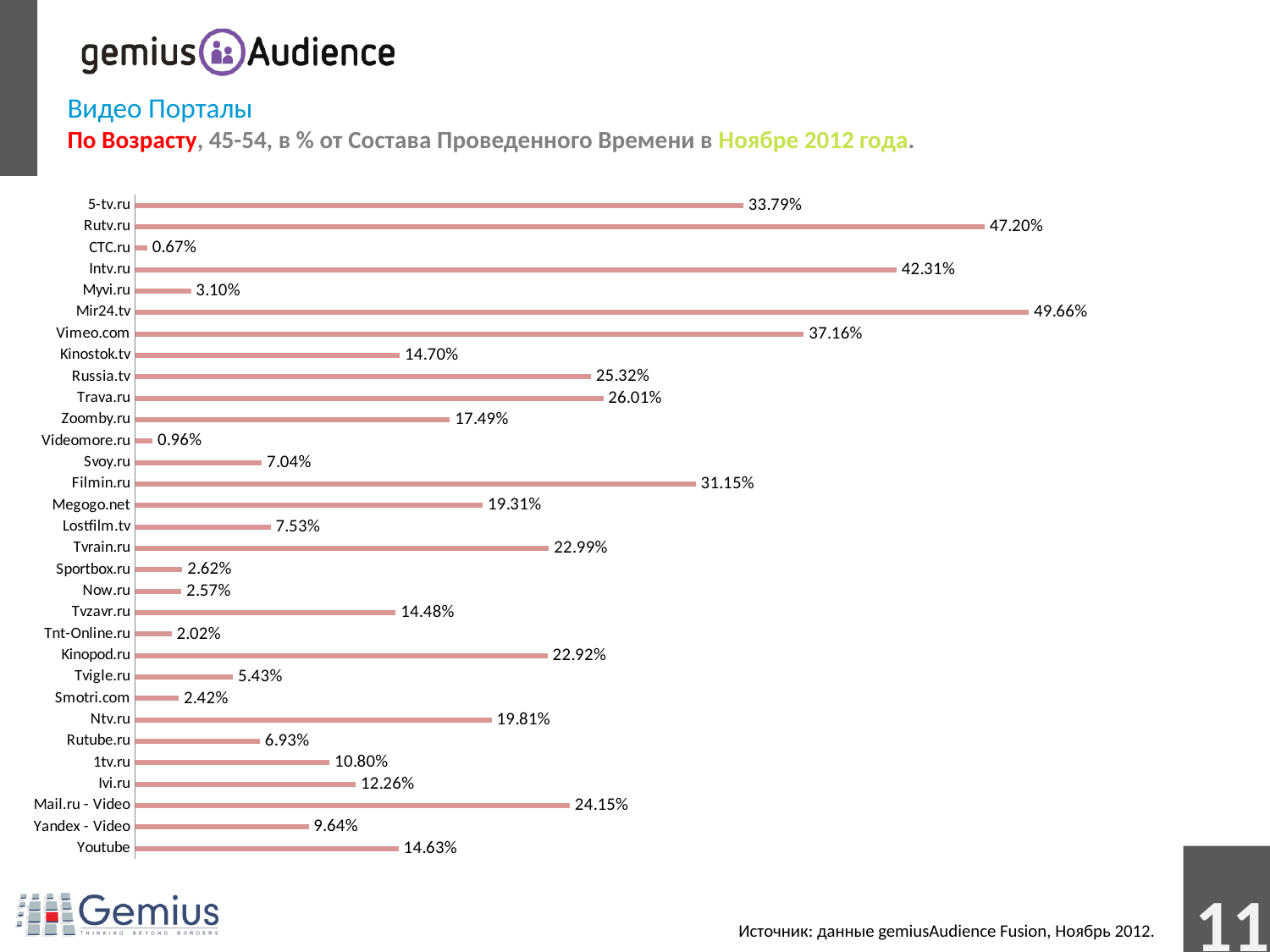
Which has a larger value, Ivi.ru or 1tv.ru? Ivi.ru What is the value for Mir24.tv? 49.66% What kind of chart is shown on the slide? Bar chart What is the value for Vimeo.com? 37.16% Which portal has the highest value? Mir24.tv What is the difference between the values for Rutv.ru and Intv.ru? 4.89 percentage points Which has a larger value, 5-tv.ru or Filmin.ru? 5-tv.ru Which portal has the lowest value? CTC.ru What is the difference between the values for Mail.ru - Video and Yandex - Video? 14.51 percentage points How many portals are shown in the chart? 31 What is the value for Youtube? 14.63% What is the value for Tnt-Online.ru? 2.02%